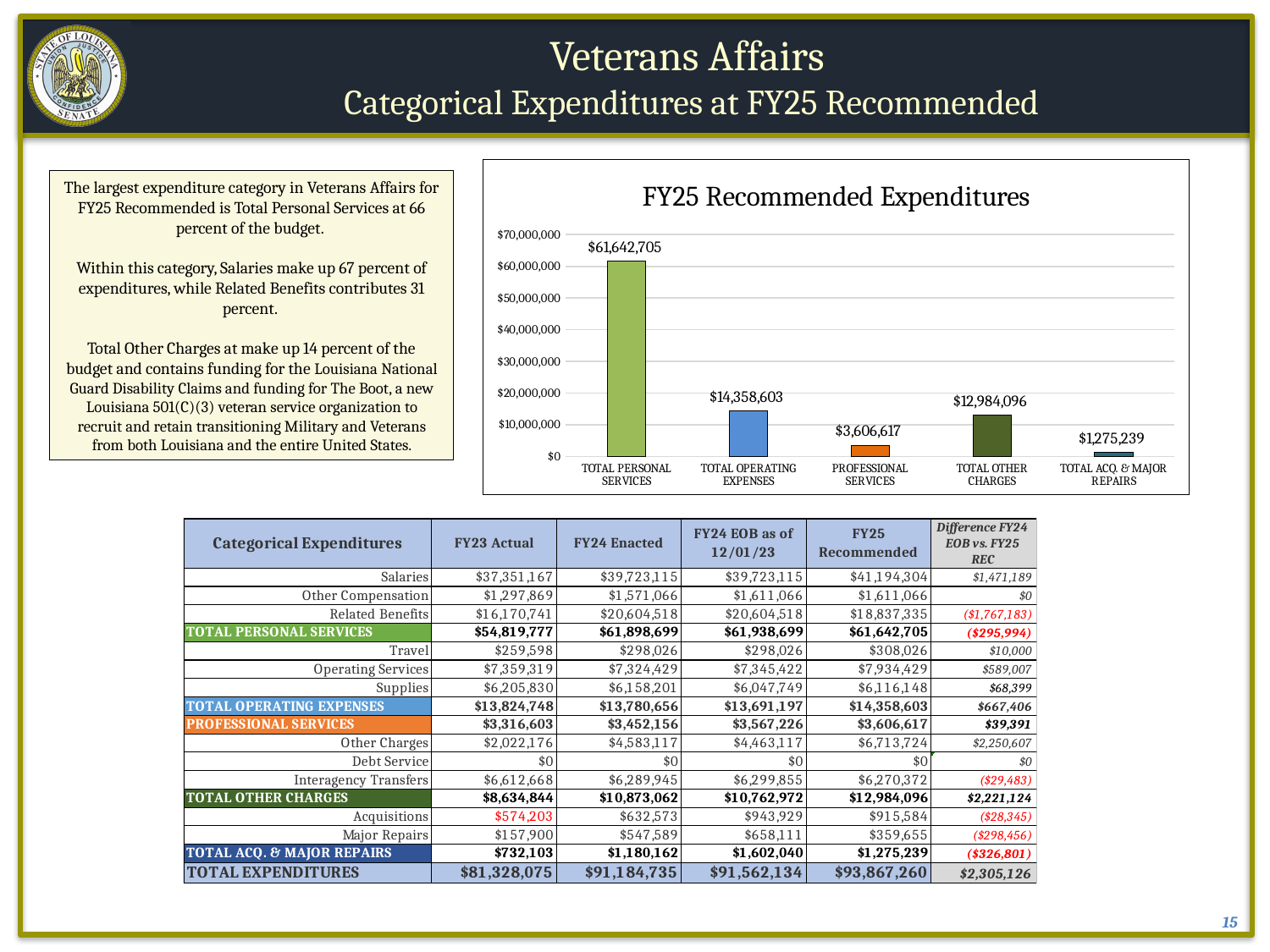
What is the value for TOTAL PERSONAL SERVICES in the FY25 Recommended Expenditures chart? $61,642,705 What is the title of the chart on the slide? FY25 Recommended Expenditures Which category has the lowest value in the FY25 Recommended Expenditures chart? TOTAL ACQ. & MAJOR REPAIRS What is the value for TOTAL OPERATING EXPENSES in the FY25 Recommended Expenditures chart? $14,358,603 In the FY25 Recommended Expenditures chart, which is larger: TOTAL OTHER CHARGES or PROFESSIONAL SERVICES? TOTAL OTHER CHARGES How many categories are shown in the FY25 Recommended Expenditures chart? 5 What type of chart is the FY25 Recommended Expenditures chart? bar chart What is the value for PROFESSIONAL SERVICES in the FY25 Recommended Expenditures chart? $3,606,617 In the FY25 Recommended Expenditures chart, what is the difference between TOTAL OPERATING EXPENSES and TOTAL OTHER CHARGES? $1,374,507 What is the value for TOTAL ACQ. & MAJOR REPAIRS in the FY25 Recommended Expenditures chart? $1,275,239 In the FY25 Recommended Expenditures chart, is the value for TOTAL PERSONAL SERVICES greater or less than $60,000,000? greater Which category has the highest value in the FY25 Recommended Expenditures chart? TOTAL PERSONAL SERVICES